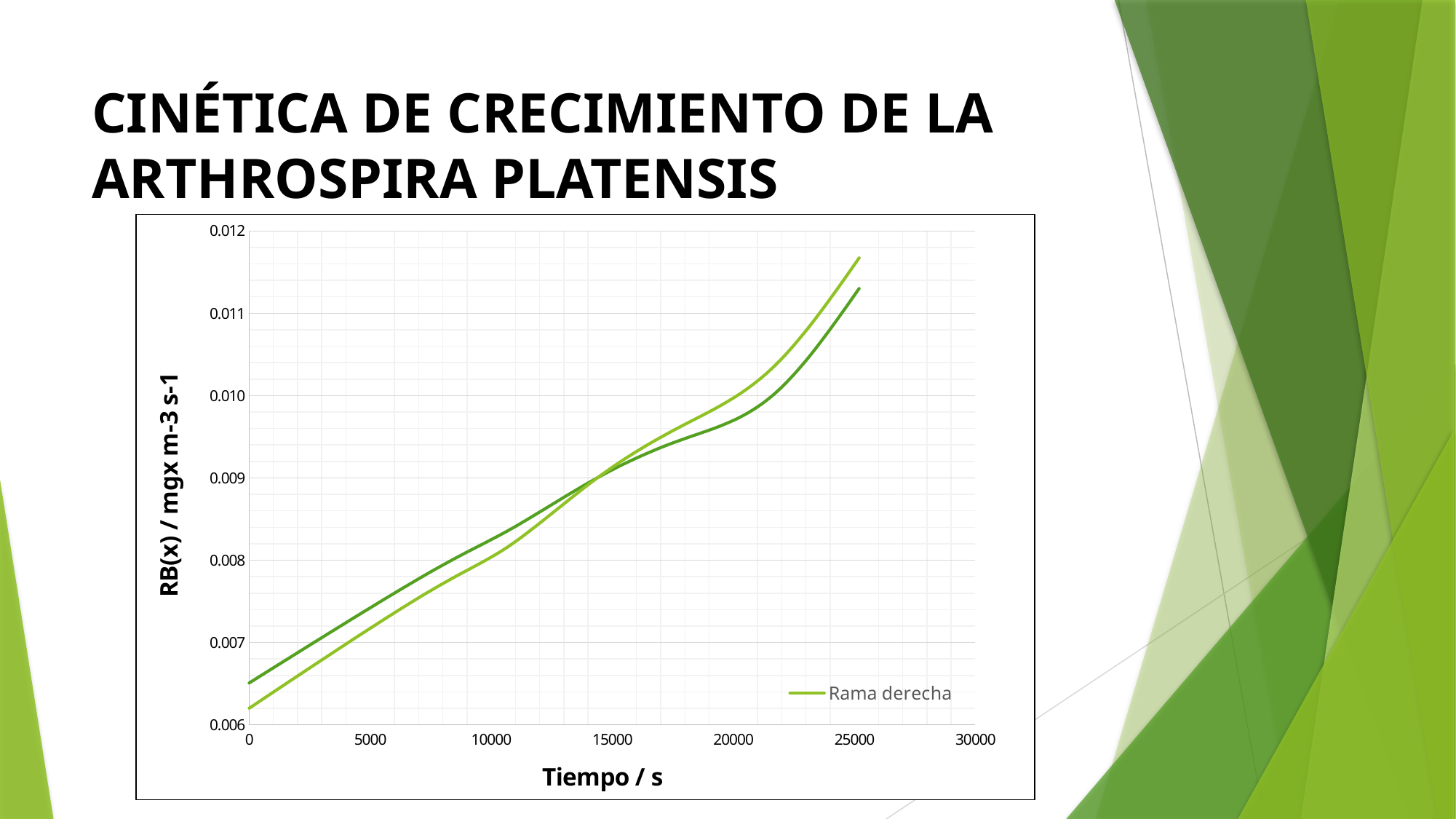
Do the values of the Rama derecha series rise or fall as time increases along the x axis? rise What is the highest value shown on the y axis? 0.012 Is the value of Rama derecha at time 5000 greater or less than 0.008? less How many series does the legend list? 1 How many lines are plotted on the chart? 2 Is the value of Rama derecha at time 20000 greater or less than 0.009? greater Is the value of Rama derecha at time 0 greater or less than 0.007? less What is the title of the x axis? Tiempo / s What kind of chart is shown on the slide? line chart What is the name of the series listed in the legend? Rama derecha